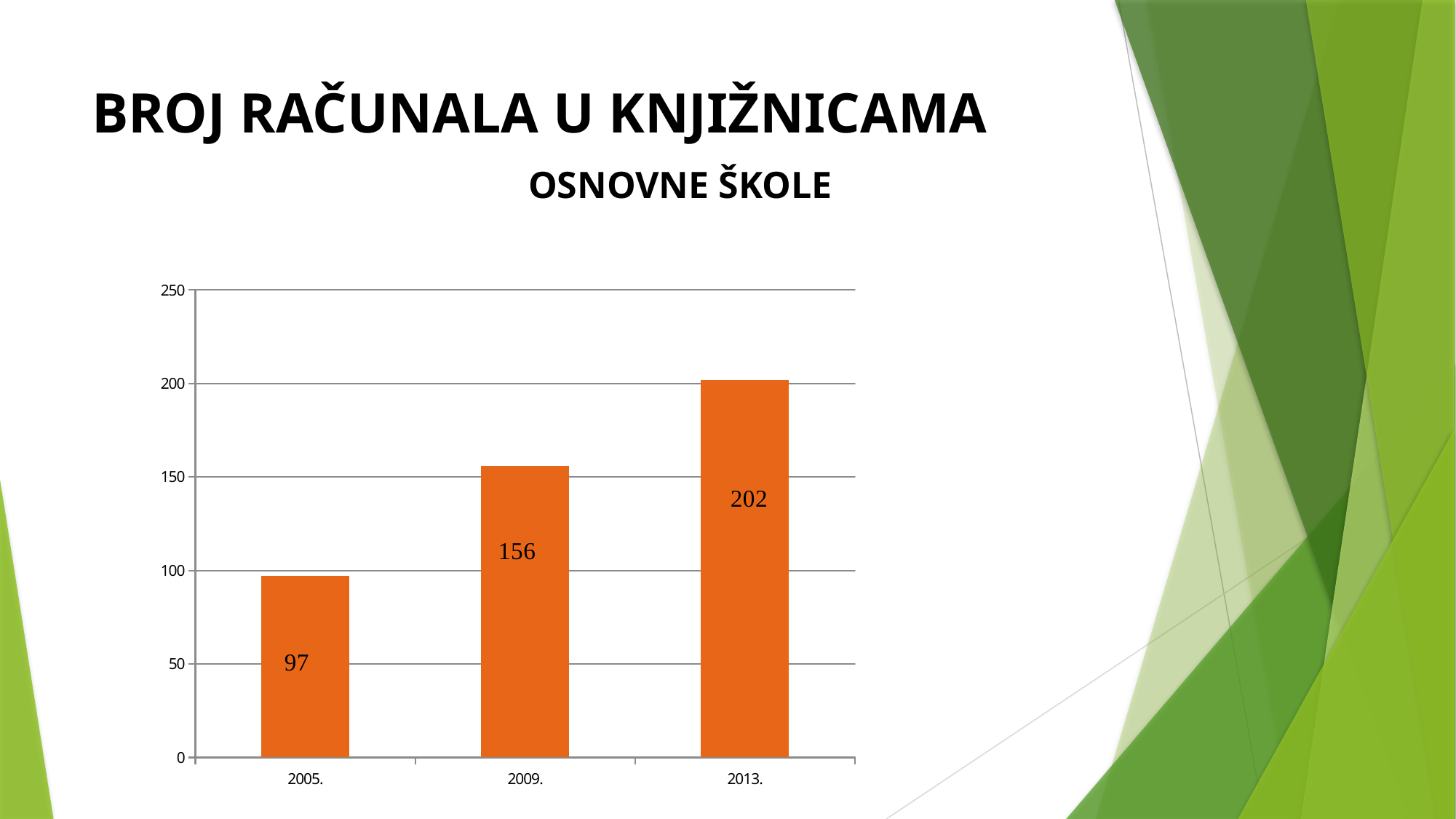
What is the value for 2013.? 202 What is the difference between the values for 2009. and 2005.? 59 What is the value for 2009.? 156 What kind of chart is shown on the slide? bar chart How many years are shown on the x axis? 3 Do the values rise or fall from 2005. to 2013.? rise Which is larger, the value for 2009. or the value for 2013.? 2013. Is the value for 2005. greater or less than 100? less What is the value for 2005.? 97 Which year has the lowest value? 2005. Which year has the highest value? 2013. What is the difference between the values for 2013. and 2005.? 105